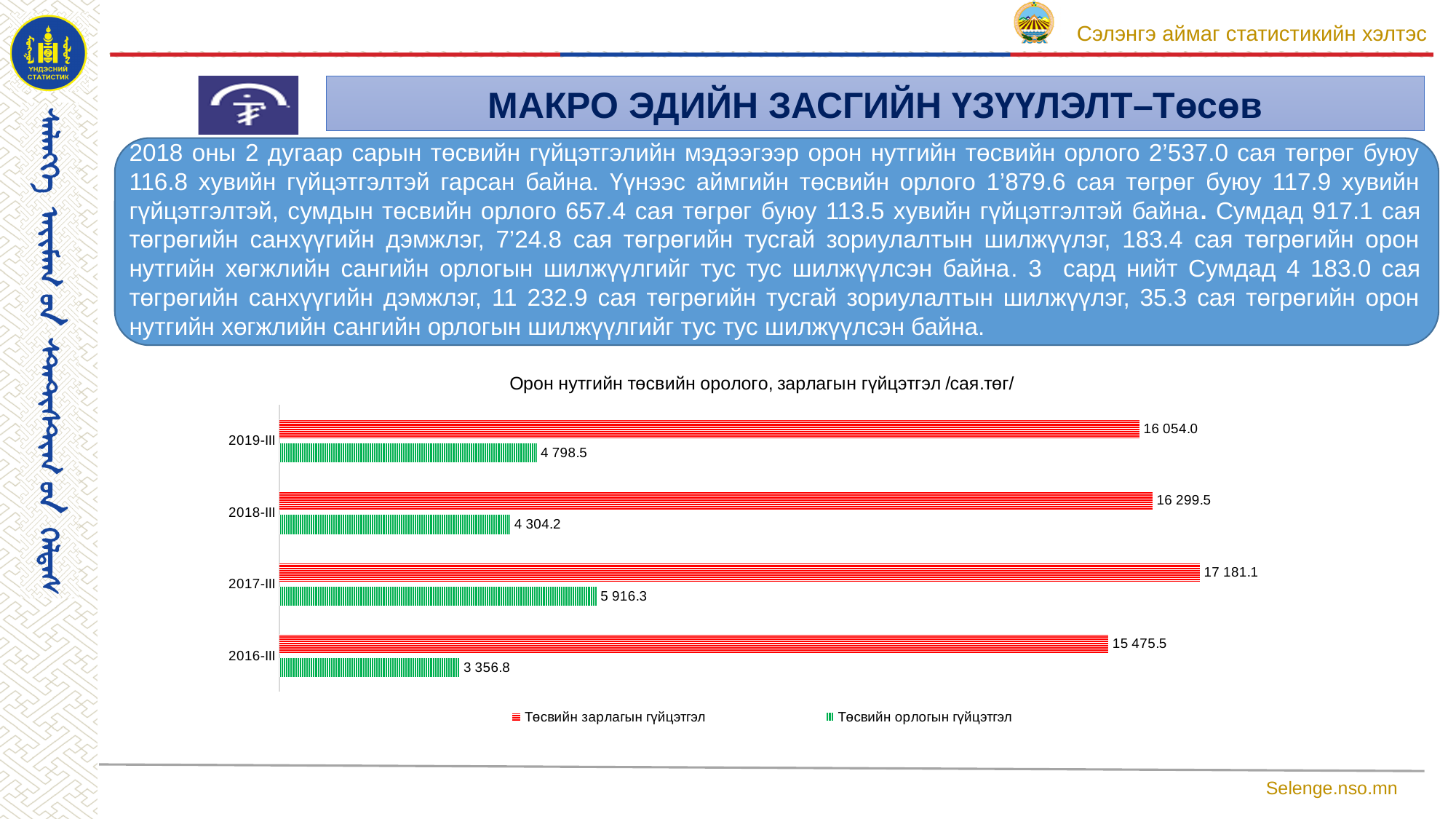
Which is larger: Төсвийн зарлагын гүйцэтгэл for 2018-III or for 2019-III? 2018-III What is the difference between the Төсвийн орлогын гүйцэтгэл values for 2017-III and 2016-III? 2 559.5 Which period has the highest value for Төсвийн зарлагын гүйцэтгэл? 2017-III How many series does the legend list? 2 What is the difference between Төсвийн зарлагын гүйцэтгэл and Төсвийн орлогын гүйцэтгэл for 2017-III? 11 264.8 What is the value of Төсвийн зарлагын гүйцэтгэл for 2019-III? 16 054.0 What type of chart is shown on the slide? bar chart How many periods are shown on the chart? 4 What is the value of Төсвийн орлогын гүйцэтгэл for 2018-III? 4 304.2 Which period has the lowest value for Төсвийн орлогын гүйцэтгэл? 2016-III What is the value of Төсвийн орлогын гүйцэтгэл for 2016-III? 3 356.8 What is the title of the chart? Орон нутгийн төсвийн оролого, зарлагын гүйцэтгэл /сая.төг/